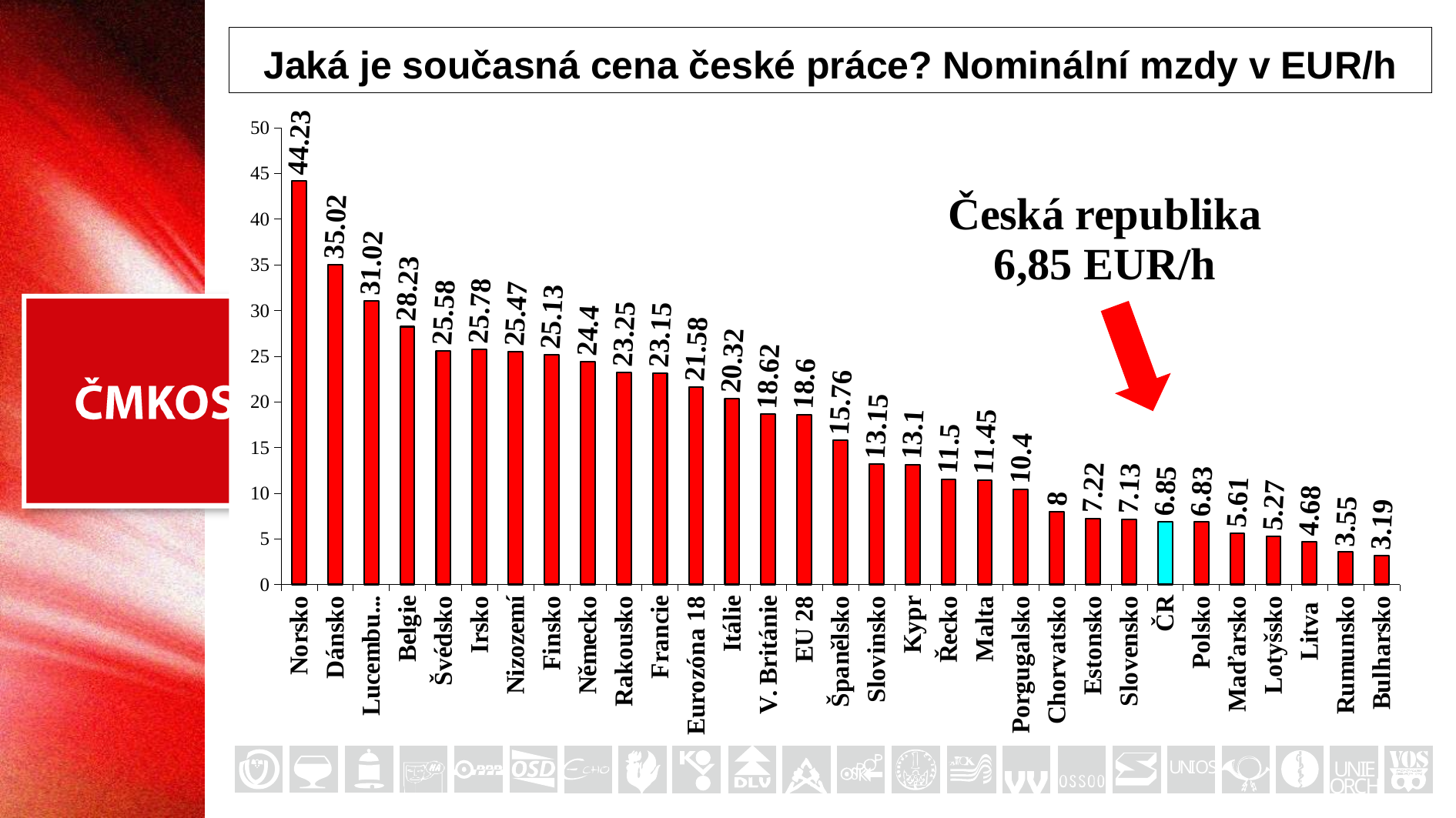
What is the difference between the values for Slovensko and ČR? 0.28 What is the value for ČR? 6.85 Which category has the highest value? Norsko What is the value for EU 28? 18.6 What is the value for Norsko? 44.23 How many categories are shown on the x axis? 31 Which is larger, the value for Belgie or the value for Francie? Belgie What is the value for Německo? 24.4 Do the values rise or fall from left to right along the x axis? fall What is the difference between the values for Norsko and Dánsko? 9.21 What kind of chart is this? bar chart Which category has the lowest value? Bulharsko